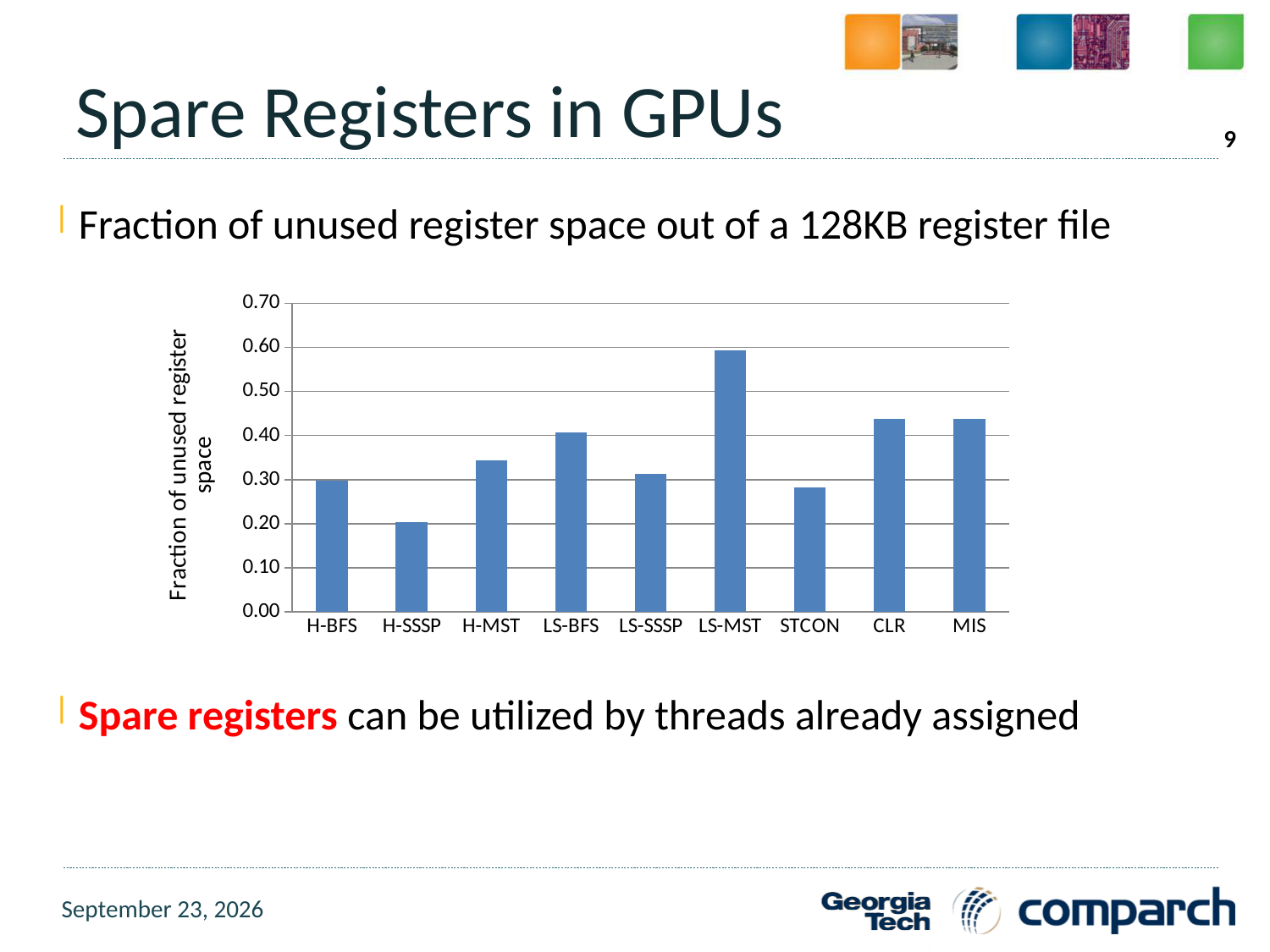
Which has a larger fraction of unused register space, LS-BFS or LS-SSSP? LS-BFS Is the value for H-SSSP greater or less than 0.30? less Which has a larger fraction of unused register space, H-MST or H-SSSP? H-MST How many benchmarks (categories) are plotted on the x axis? 9 What is the label of the y axis? Fraction of unused register space Is the value for CLR greater or less than 0.40? greater Is the value for LS-MST greater or less than 0.50? greater Which benchmark has the lowest fraction of unused register space? H-SSSP Which benchmark has the highest fraction of unused register space? LS-MST What kind of chart is shown on the slide? bar chart